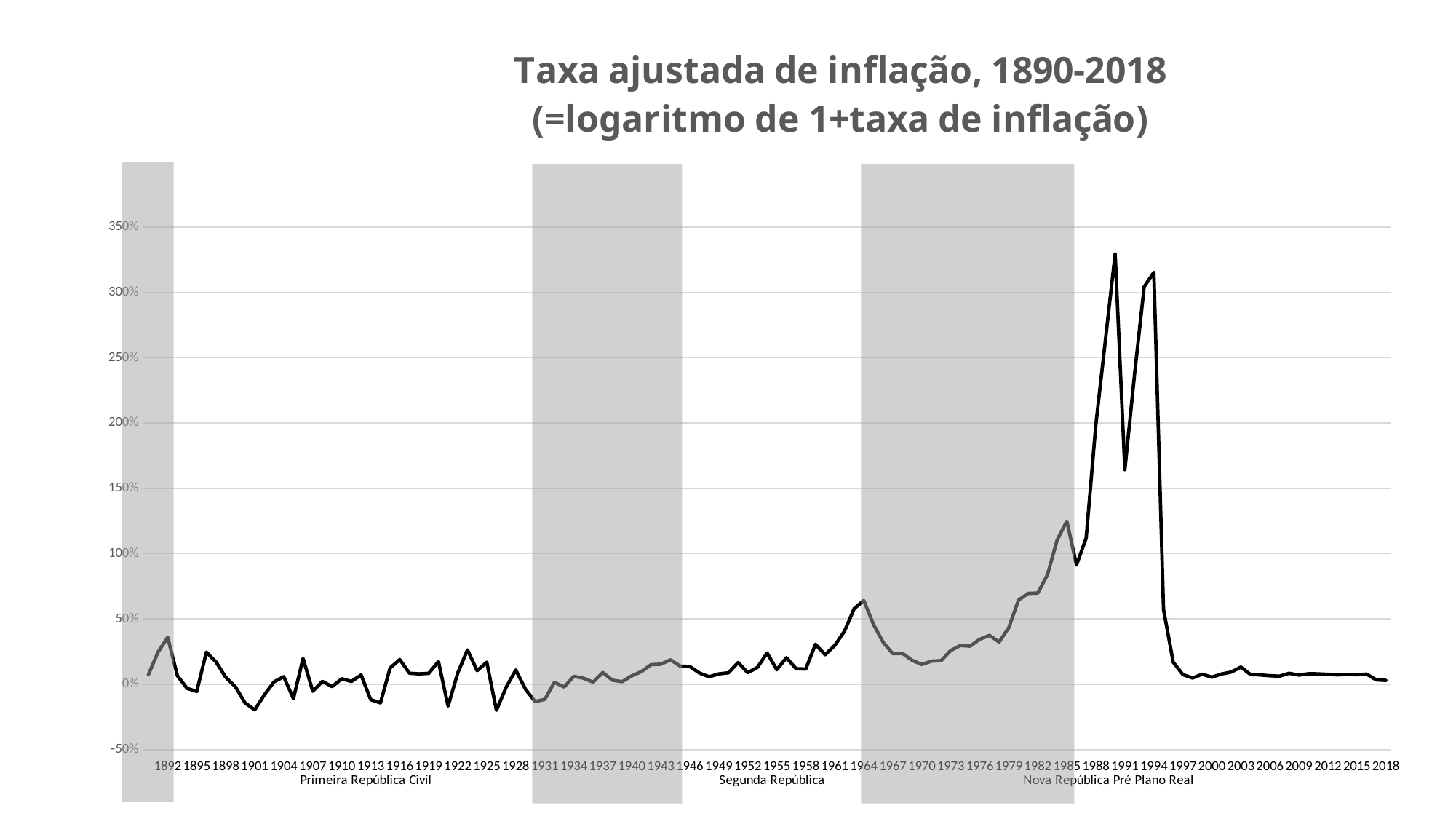
Is the value for 2018 greater or less than 50%? less Do the values generally rise or fall between 1994 and 1997? fall Is the value for 1990 greater or less than 300%? greater Is the value for 1985 greater or less than 100%? greater What is the title of the chart? Taxa ajustada de inflação, 1890-2018 (=logaritmo de 1+taxa de inflação) How many lines are plotted on the chart? 1 Do the values generally rise or fall between 1970 and 1985? rise What kind of chart is shown on the slide? line chart